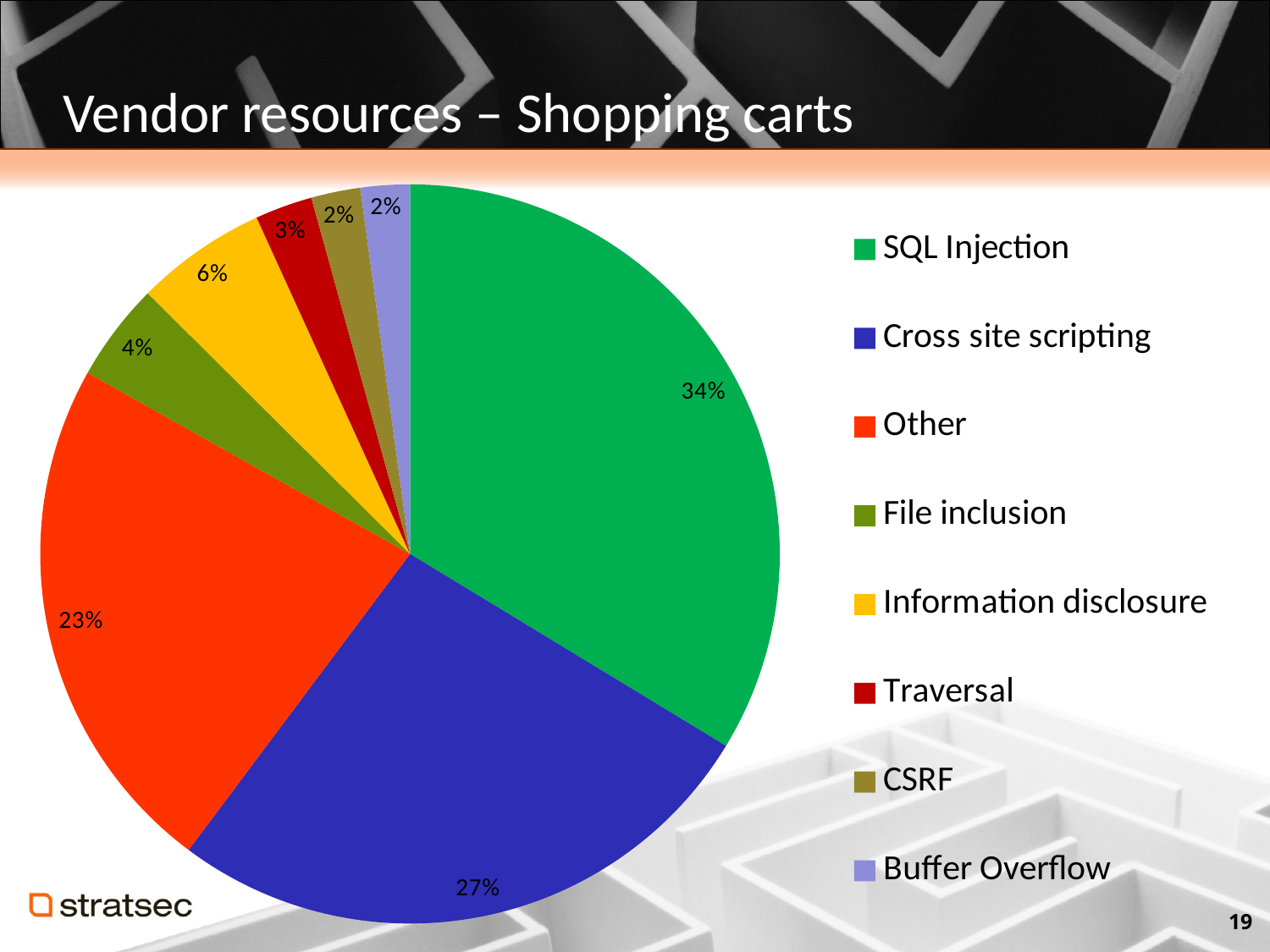
What is the value shown for File inclusion? 4% Which category has the largest slice of the pie? SQL Injection What is the difference between the SQL Injection share and the Cross site scripting share? 7% What share of the pie does Cross site scripting have? 27% What share of the pie does SQL Injection have? 34% How many categories does the legend list? 8 What is the value shown for Other? 23% What is the title of the slide containing the chart? Vendor resources – Shopping carts What is the value shown for Information disclosure? 6% Which is larger, Cross site scripting or Other? Cross site scripting What kind of chart is shown on the slide? Pie chart What is the value shown for Traversal? 3%